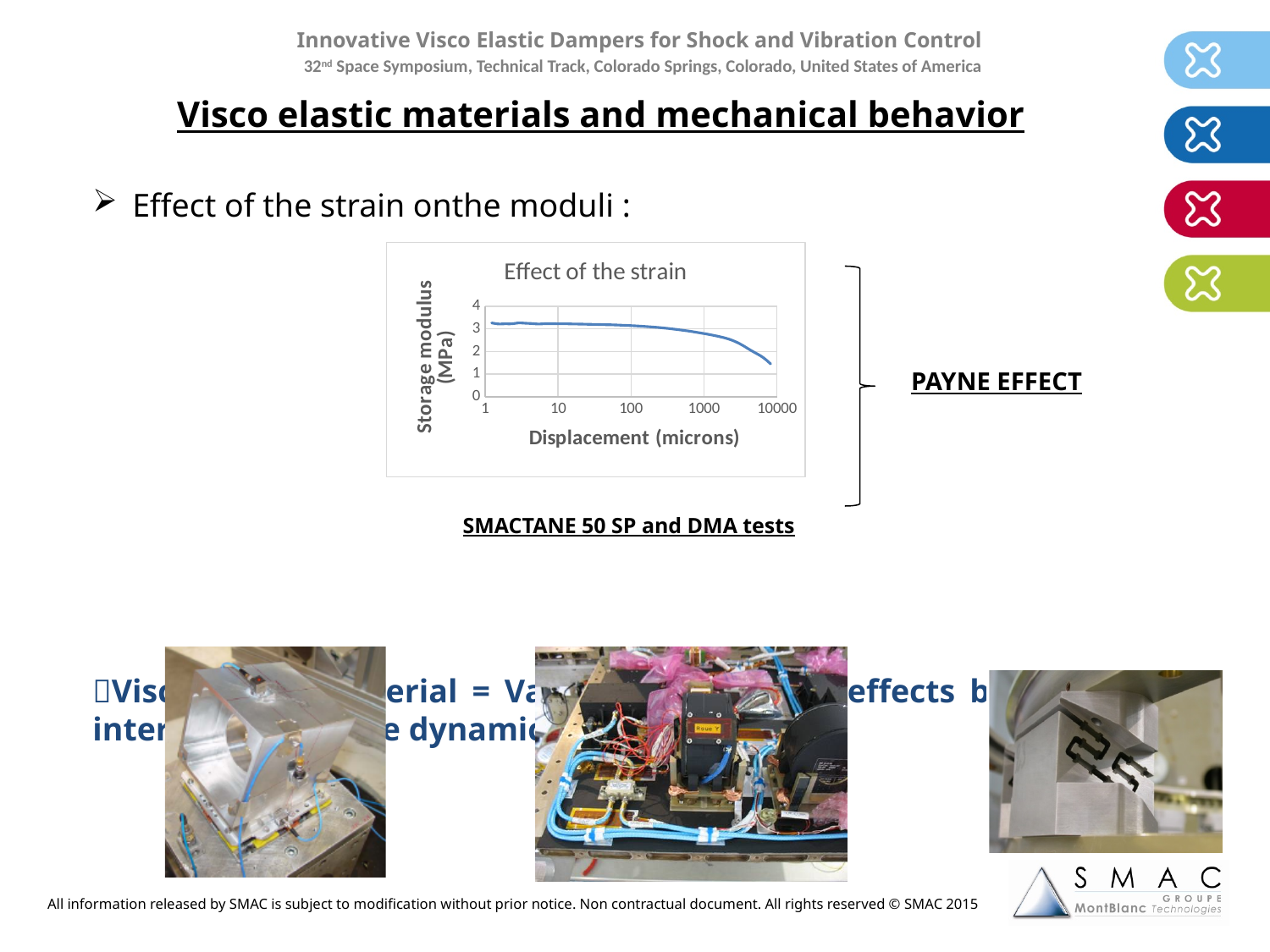
Is the storage modulus at a displacement of 1000 microns greater or less than 1 MPa? greater Which is larger, the storage modulus at 10 microns or at 10000 microns? 10 microns What is the title of the chart on the slide? Effect of the strain What is the highest value shown on the y axis of the chart? 4 Is the storage modulus at the right-hand end of the curve (near 10000 microns) greater or less than 2 MPa? less Is the storage modulus at a displacement of 10 microns greater or less than 2 MPa? greater What kind of chart is shown on the slide? line chart Does the storage modulus rise or fall as displacement increases along the x axis? fall What is the label of the x axis of the chart? Displacement (microns)